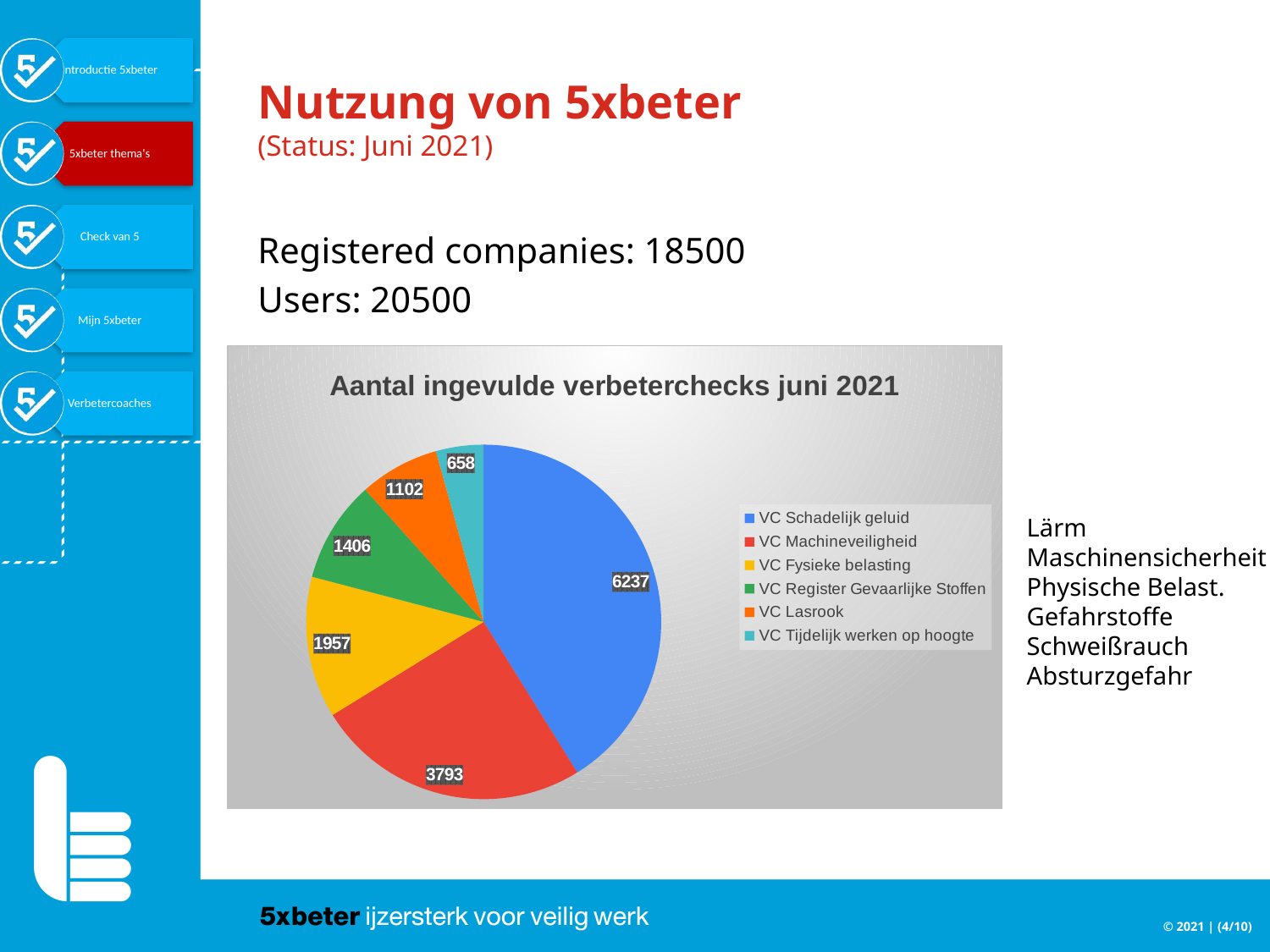
Which category has the smallest slice? VC Tijdelijk werken op hoogte What is the value for VC Machineveiligheid? 3793 What is the difference between the values for VC Schadelijk geluid and VC Machineveiligheid? 2444 How many slices does the pie chart have? 6 What is the value for VC Schadelijk geluid? 6237 Which colour represents VC Register Gevaarlijke Stoffen in the legend? green What is the value for VC Lasrook? 1102 What is the value for VC Tijdelijk werken op hoogte? 658 What is the title of the chart? Aantal ingevulde verbeterchecks juni 2021 Which is larger, the value for VC Fysieke belasting or VC Register Gevaarlijke Stoffen? VC Fysieke belasting Which category has the largest slice? VC Schadelijk geluid What type of chart is shown on the slide? pie chart